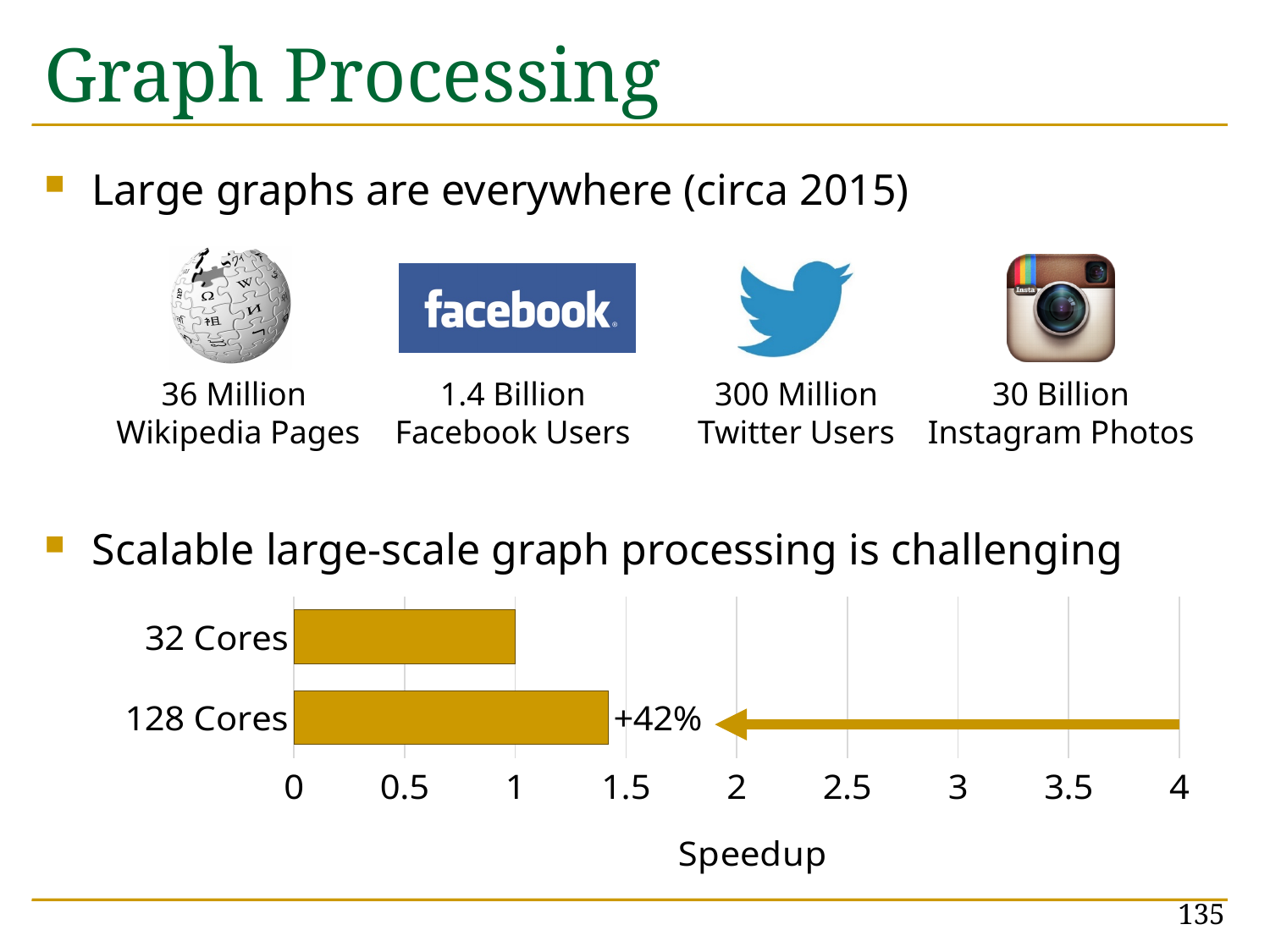
Which has a larger speedup, 32 Cores or 128 Cores? 128 Cores How many categories are plotted in the Speedup chart? 2 Which category has the lowest speedup? 32 Cores What kind of chart is shown at the bottom of the slide? bar chart Is the speedup for 128 Cores greater or less than 1? greater What annotation is printed next to the 128 Cores bar? +42% Which category has the highest speedup? 128 Cores Is the speedup for 32 Cores greater or less than 2? less Is the speedup for 128 Cores greater or less than 1.5? less What is the speedup value for 32 Cores? 1 What is the label on the x axis of the chart? Speedup